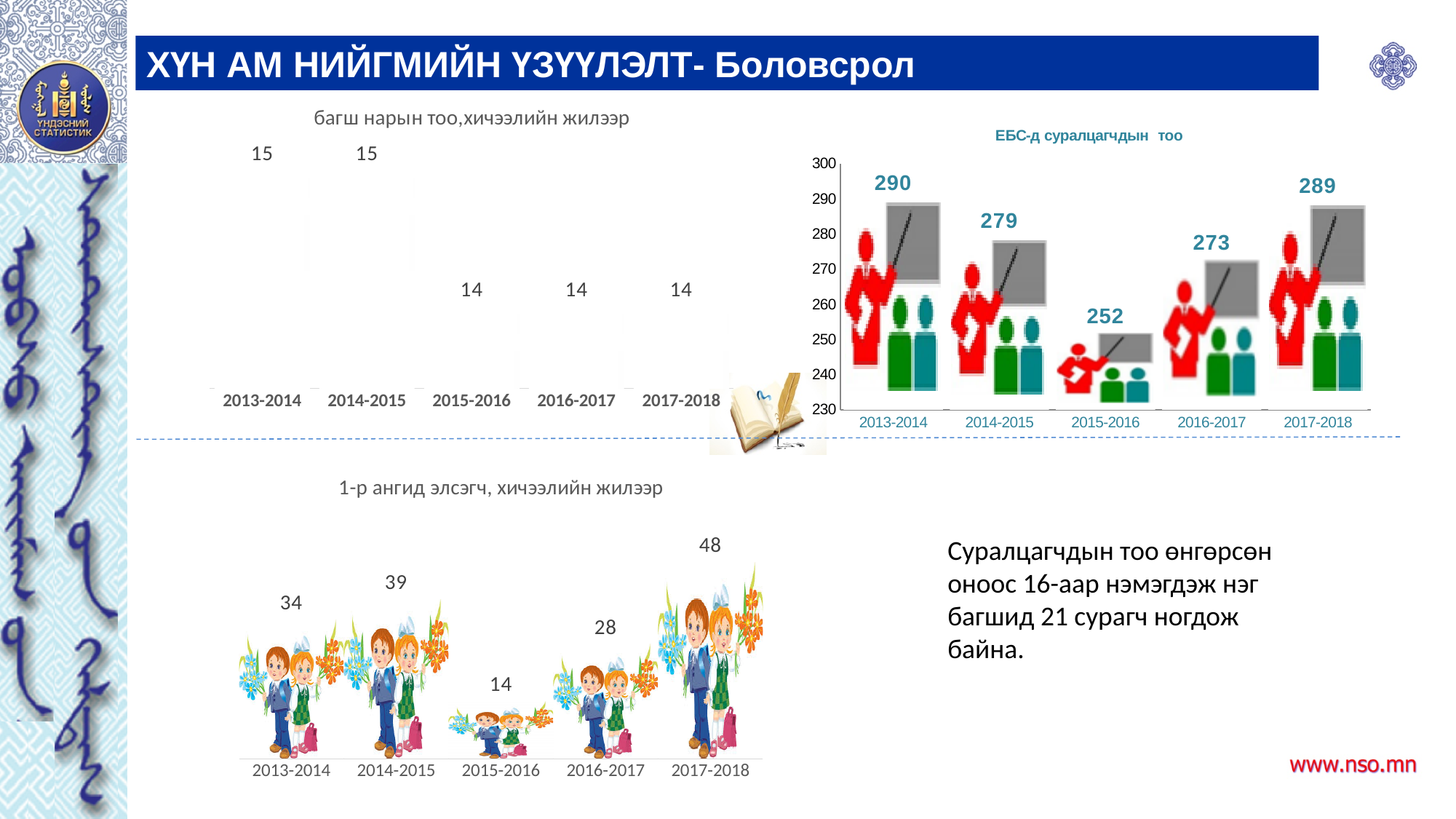
In the chart titled "ЕБС-д суралцагчдын тоо", which school year has the lowest value? 2015-2016 In the chart titled "багш нарын тоо,хичээлийн жилээр", what is the value for 2013-2014? 15 In the chart titled "1-р ангид элсэгч, хичээлийн жилээр", what is the difference between the values for 2017-2018 and 2013-2014? 14 How many school years are shown on the x axis of the chart titled "ЕБС-д суралцагчдын тоо"? 5 In the chart titled "ЕБС-д суралцагчдын тоо", is the value for 2014-2015 greater or less than 270? greater In the chart titled "ЕБС-д суралцагчдын тоо", what is the value for 2015-2016? 252 In the chart titled "1-р ангид элсэгч, хичээлийн жилээр", which is larger, the value for 2014-2015 or the value for 2016-2017? 2014-2015 In the chart titled "ЕБС-д суралцагчдын тоо", what is the difference between the values for 2017-2018 and 2016-2017? 16 In the chart titled "1-р ангид элсэгч, хичээлийн жилээр", which school year has the lowest value? 2015-2016 In the chart titled "1-р ангид элсэгч, хичээлийн жилээр", what is the value for 2017-2018? 48 In the chart titled "багш нарын тоо,хичээлийн жилээр", what is the value for 2017-2018? 14 In the chart titled "ЕБС-д суралцагчдын тоо", which school year has the highest value? 2013-2014